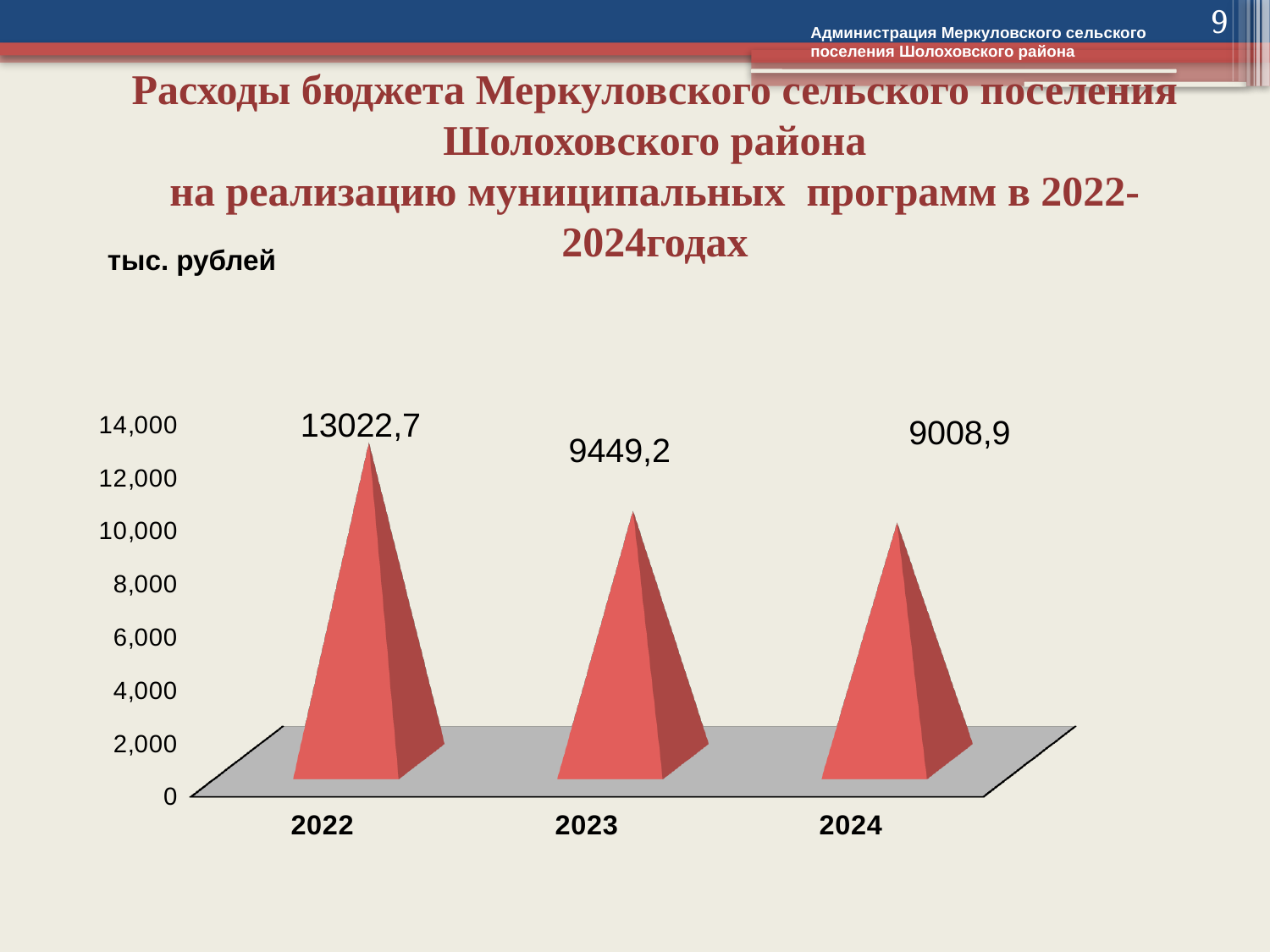
Which year has the highest value? 2022 What is the difference between the values for 2023 and 2024? 440,3 Do the values rise or fall from 2022 to 2024? fall Which is larger, the value for 2022 or the value for 2024? 2022 What is the value for 2023? 9449,2 How many years are shown on the x axis? 3 What is the value for 2022? 13022,7 Which year has the lowest value? 2024 What kind of chart is shown on the slide? bar chart What is the difference between the values for 2022 and 2023? 3573,5 Is the value for 2022 greater or less than 12,000? greater What is the value for 2024? 9008,9